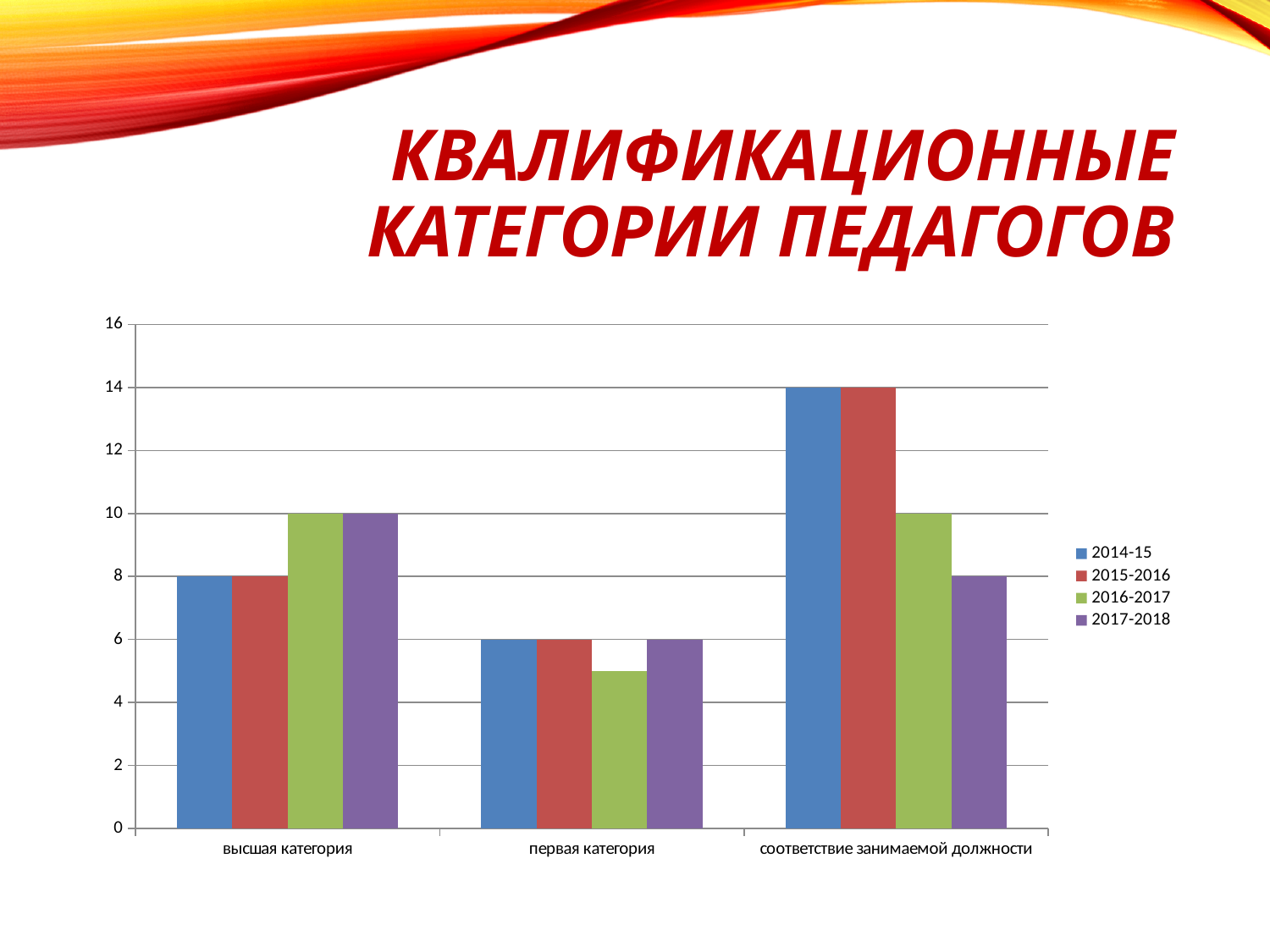
Which category has the highest value for the 2014-15 series? соответствие занимаемой должности Which is larger in the category 'высшая категория': the value for 2014-15 or the value for 2017-2018? 2017-2018 What is the value for 2016-2017 in the category 'высшая категория'? 10 Which category has the lowest value for the 2017-2018 series? первая категория What is the value for 2015-2016 in the category 'первая категория'? 6 Is the value for 2016-2017 in the category 'первая категория' greater or less than 6? less What type of chart is shown on the slide? bar chart What is the value for 2017-2018 in the category 'соответствие занимаемой должности'? 8 What is the value for 2014-15 in the category 'соответствие занимаемой должности'? 14 How many series does the legend list? 4 How many categories are shown on the x axis? 3 What is the difference between the 2014-15 and 2017-2018 values in the category 'соответствие занимаемой должности'? 6